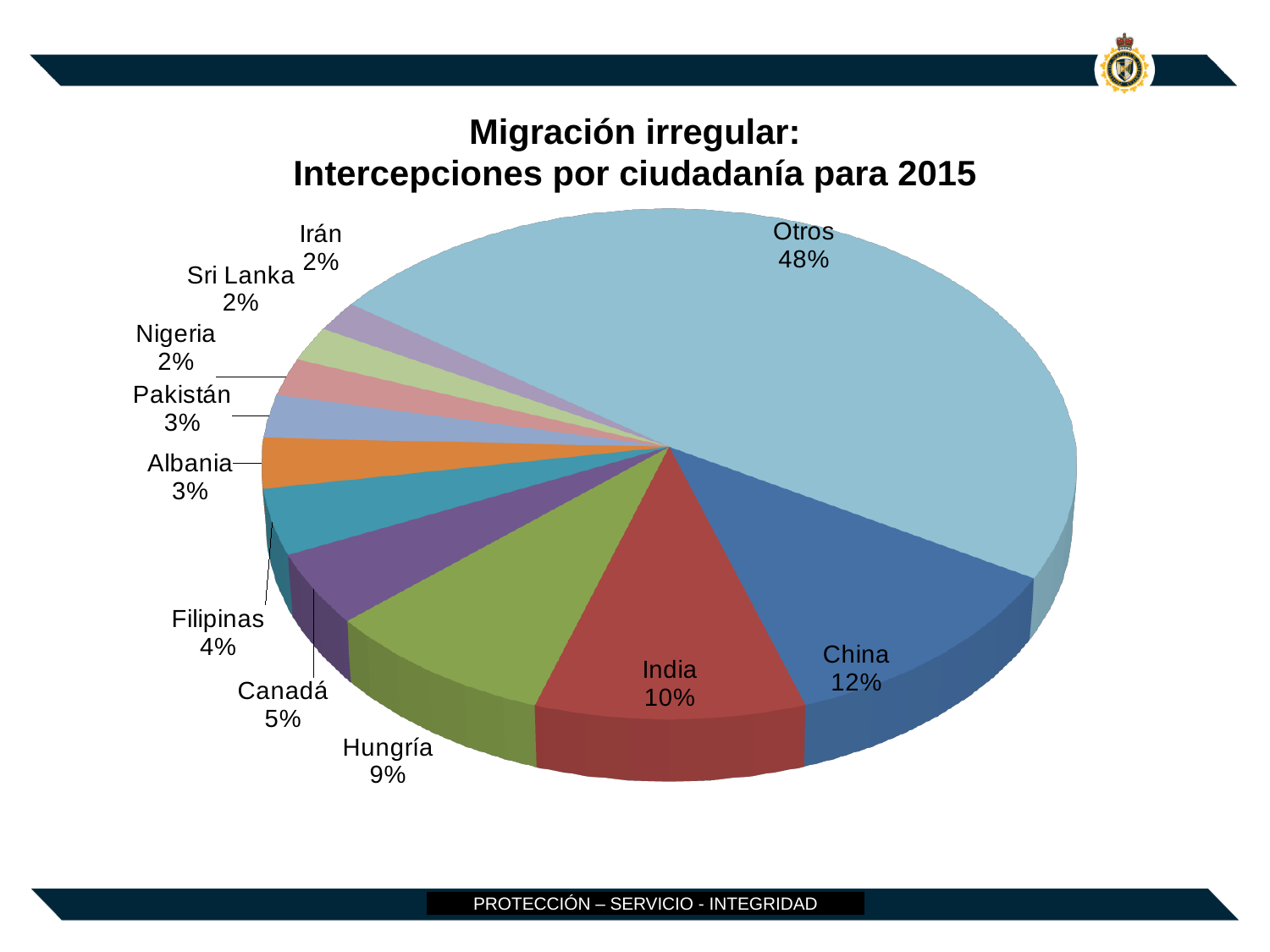
What percentage is shown for Filipinas? 4% Which named country (excluding Otros) has the largest share? China What is the difference in percentage points between India and Canadá? 5 What share of interceptions does China account for? 12% What is the title of the chart? Migración irregular: Intercepciones por ciudadanía para 2015 Which is larger, the share for Hungría or the share for Filipinas? Hungría What percentage is shown for Pakistán? 3% What percentage is shown for Hungría? 9% How many slices does the pie chart have? 11 What kind of chart is shown on the slide? Pie chart Which category has the largest slice of the pie? Otros What is the combined share of Nigeria, Sri Lanka and Irán? 6%